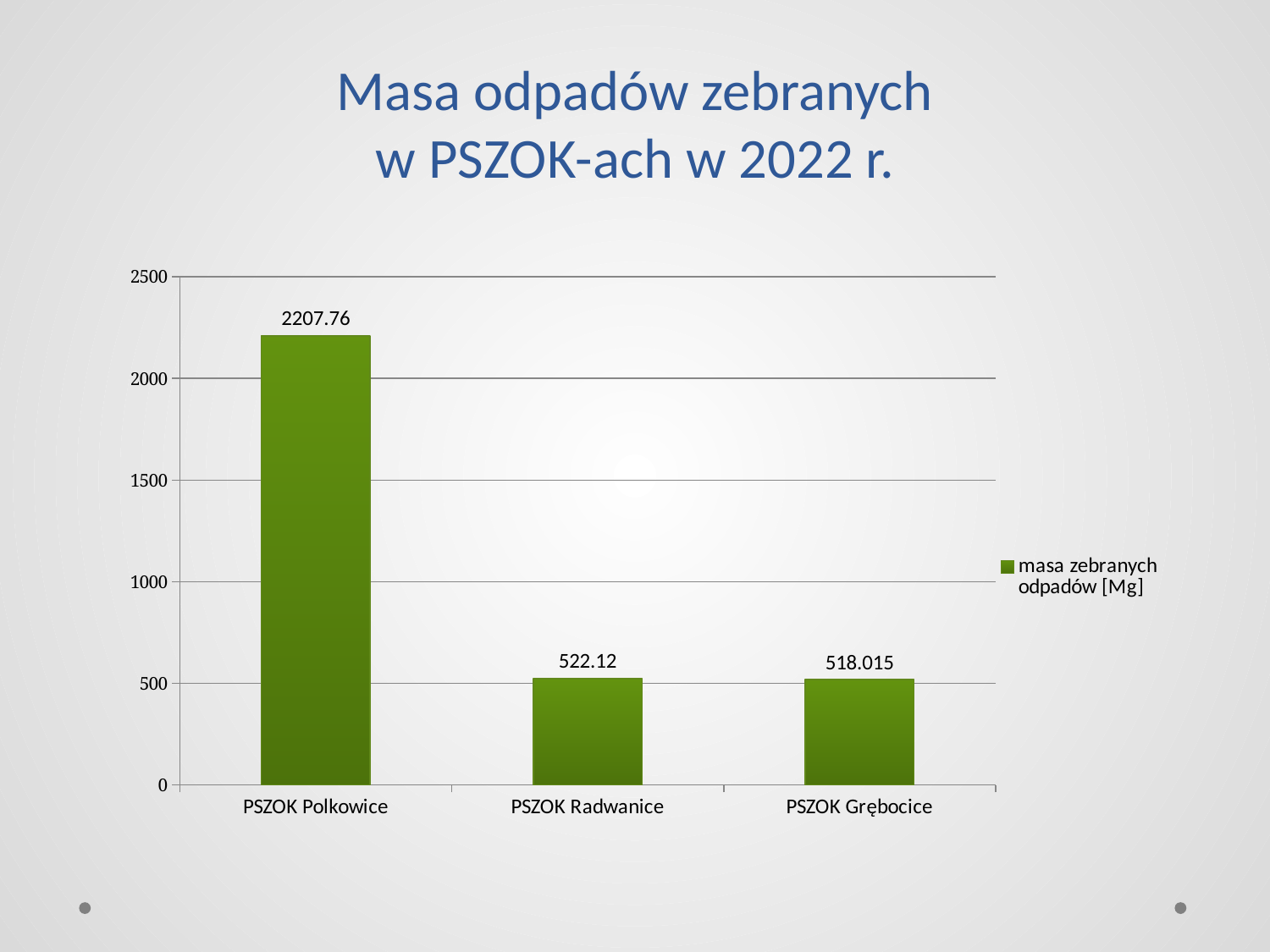
Which is larger, the value for PSZOK Polkowice or the value for PSZOK Grębocice? PSZOK Polkowice Is the value for PSZOK Polkowice greater or less than 2000? greater What is the difference between the values for PSZOK Radwanice and PSZOK Grębocice? 4.105 Which PSZOK has the highest mass of collected waste? PSZOK Polkowice Is the value for PSZOK Radwanice greater or less than 1000? less Which PSZOK has the lowest mass of collected waste? PSZOK Grębocice What is the value for PSZOK Polkowice? 2207.76 How many PSZOK categories are shown on the chart? 3 What is the difference between the values for PSZOK Polkowice and PSZOK Radwanice? 1685.64 What kind of chart is shown on the slide? bar chart What is the value for PSZOK Grębocice? 518.015 What is the value for PSZOK Radwanice? 522.12